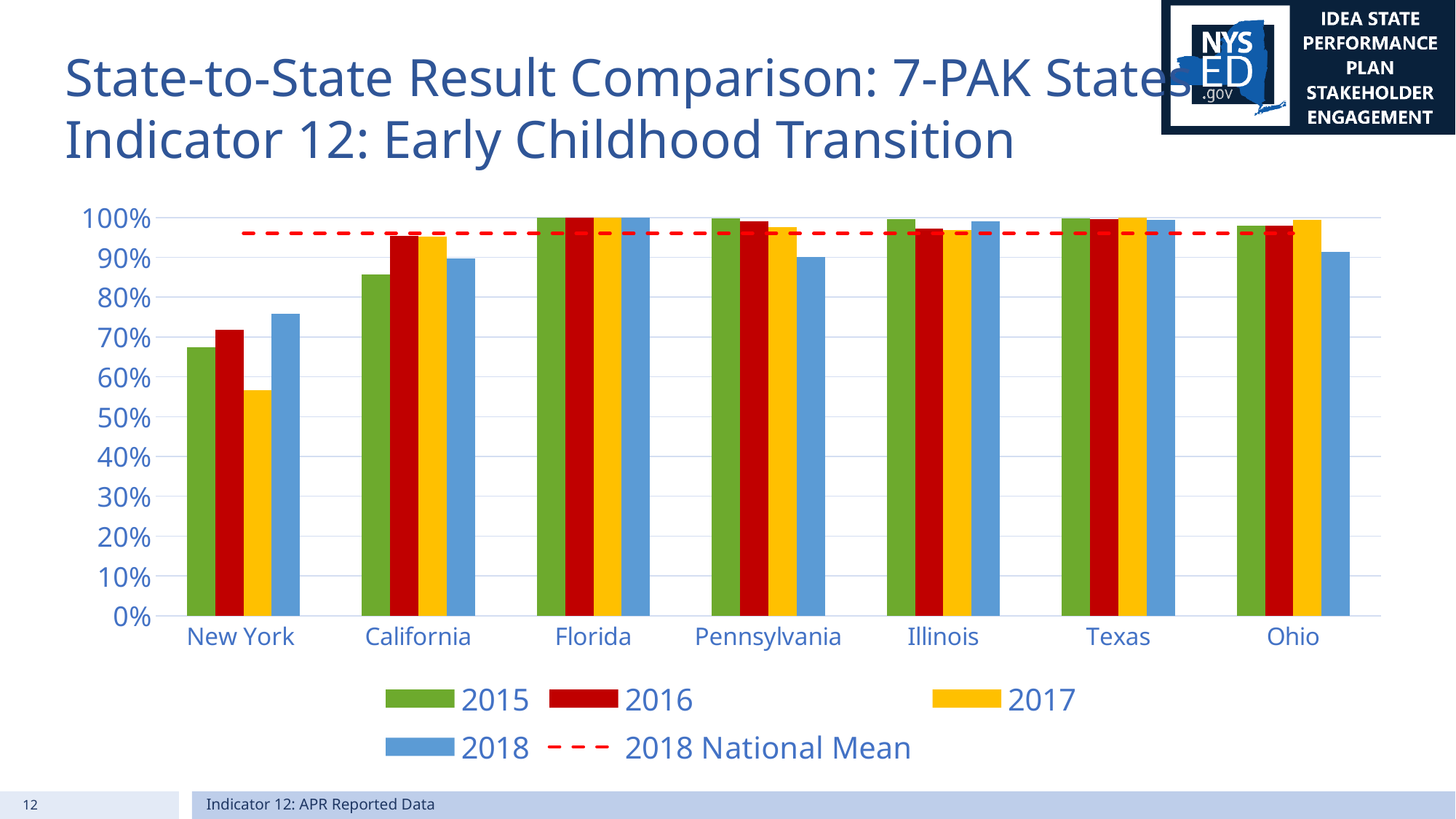
Is the 2015 value for California greater or less than 80%? greater Which state has the lowest value for 2015? New York For California, which is larger: the 2016 value or the 2015 value? 2016 How many entries does the chart's legend list? 5 For New York, which is larger: the 2018 value or the 2017 value? 2018 What does the red dashed line in the chart represent? 2018 National Mean How many states are shown on the x axis of the chart? 7 Is the 2018 value for Pennsylvania greater or less than 80%? greater Which state has the lowest value for 2017? New York Is the 2018 value for New York greater or less than 70%? greater What kind of chart is shown on the slide? bar chart